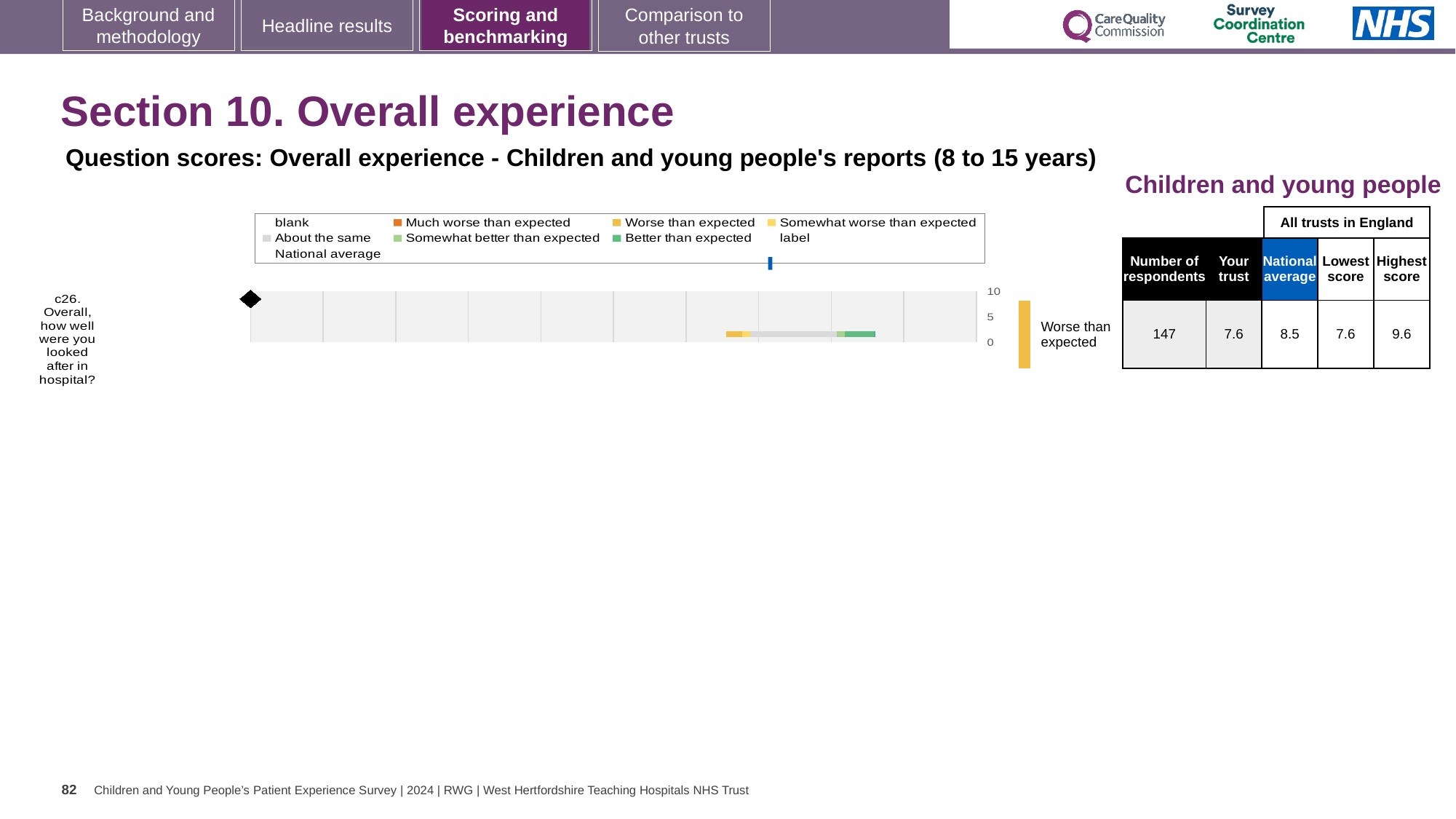
What is the highest score among all trusts in England for question c26? 9.6 How many respondents answered question c26? 147 What benchmarking category label is shown to the right of the bar for question c26? Worse than expected What is the difference between the highest and lowest scores among all trusts in England for question c26? 2.0 How many survey questions are plotted in the chart on this slide? 1 What is the 'Your trust' score for question c26? 7.6 Which is higher for question c26: the trust's score or the national average? National average What kind of chart is used to show the benchmarking result for question c26? bar chart What is the lowest score among all trusts in England for question c26? 7.6 By how much does the national average exceed the trust's score for question c26? 0.9 What is the national average score for question c26? 8.5 Which question is plotted in the chart? c26. Overall, how well were you looked after in hospital?